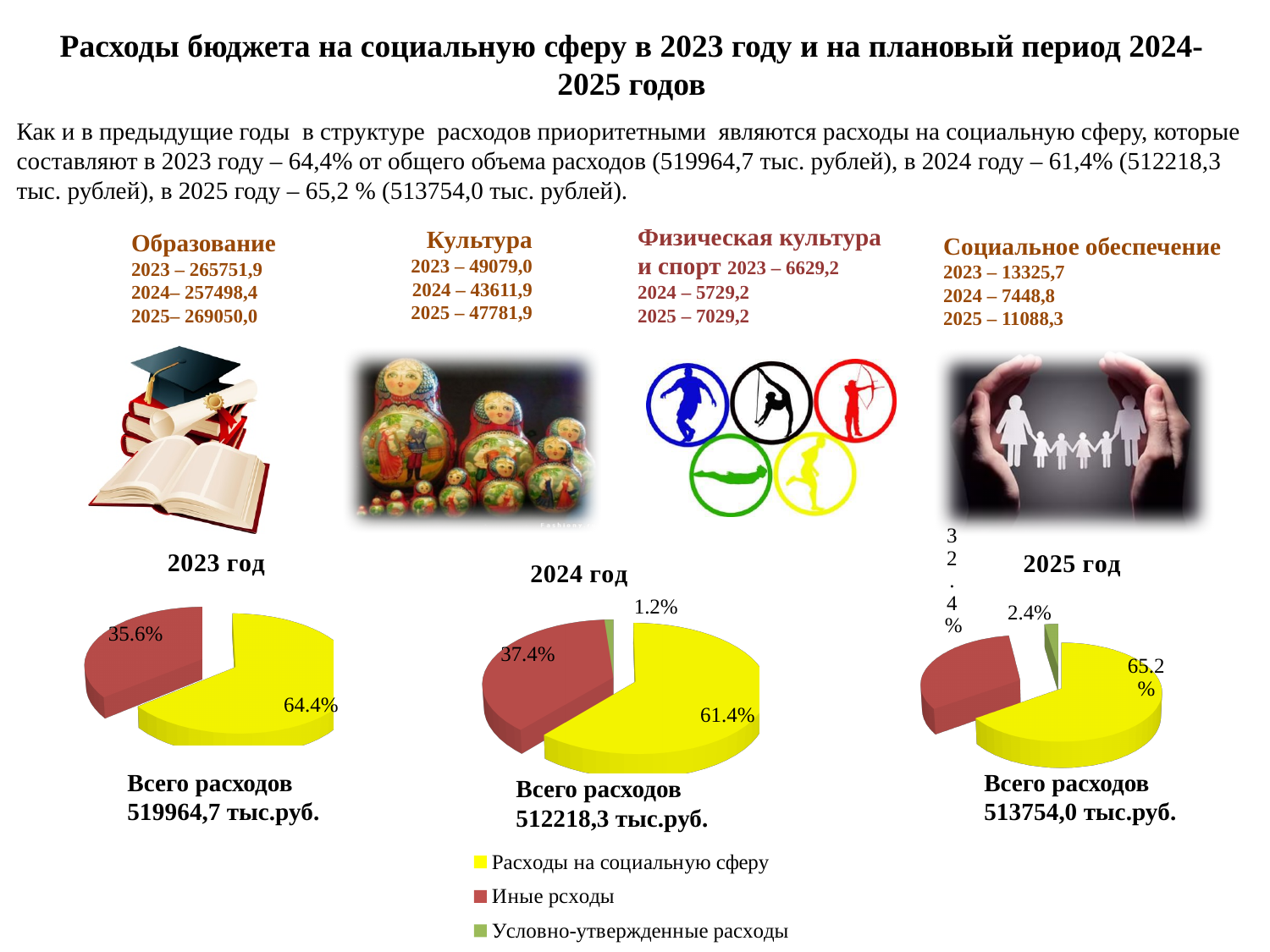
In the 2023 год pie chart, what is the difference between the share for Расходы на социальную сферу and the share for Иные рсходы? 28.8% How many slices does the 2024 год pie chart have? 3 In the 2024 год pie chart, which slice is the largest? Расходы на социальную сферу How many entries does the legend below the pie charts list? 3 In the 2023 год pie chart, what share is shown for the red slice (Иные рсходы)? 35.6% In the 2024 год pie chart, what share is shown for Условно-утвержденные расходы? 1.2% In the 2025 год pie chart, which slice is the smallest? Условно-утвержденные расходы What kind of charts are the three charts at the bottom of the slide (2023 год, 2024 год, 2025 год)? Pie charts In the 2024 год pie chart, what share is shown for Расходы на социальную сферу? 61.4% In the 2025 год pie chart, what share is shown for Условно-утвержденные расходы? 2.4% In the 2023 год pie chart, what share is shown for the yellow slice (Расходы на социальную сферу)? 64.4% In the 2025 год pie chart, what share is shown for Расходы на социальную сферу? 65.2%